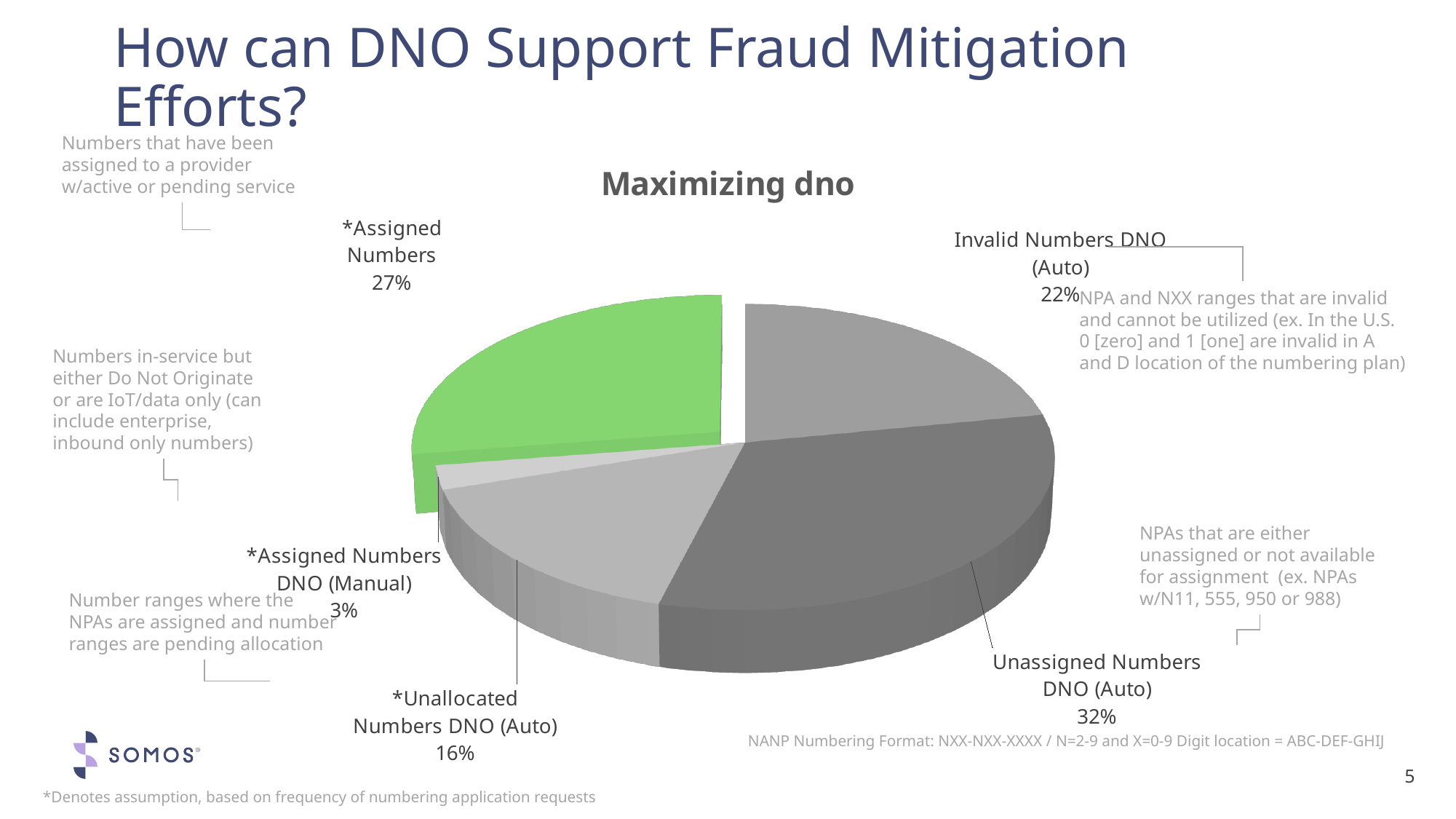
How many slices does the pie chart have? 5 What share of the pie is *Assigned Numbers? 27% Which slice of the pie is the largest? Unassigned Numbers DNO (Auto) What share of the pie is Invalid Numbers DNO (Auto)? 22% What is the title of the chart? Maximizing dno What kind of chart is shown on the slide? Pie chart What is the difference in percentage points between Unassigned Numbers DNO (Auto) and *Assigned Numbers? 5 What share of the pie is *Assigned Numbers DNO (Manual)? 3% What share of the pie is Unassigned Numbers DNO (Auto)? 32% Which slice of the pie is the smallest? *Assigned Numbers DNO (Manual) Which is larger, the share for Invalid Numbers DNO (Auto) or the share for *Unallocated Numbers DNO (Auto)? Invalid Numbers DNO (Auto) What share of the pie is *Unallocated Numbers DNO (Auto)? 16%